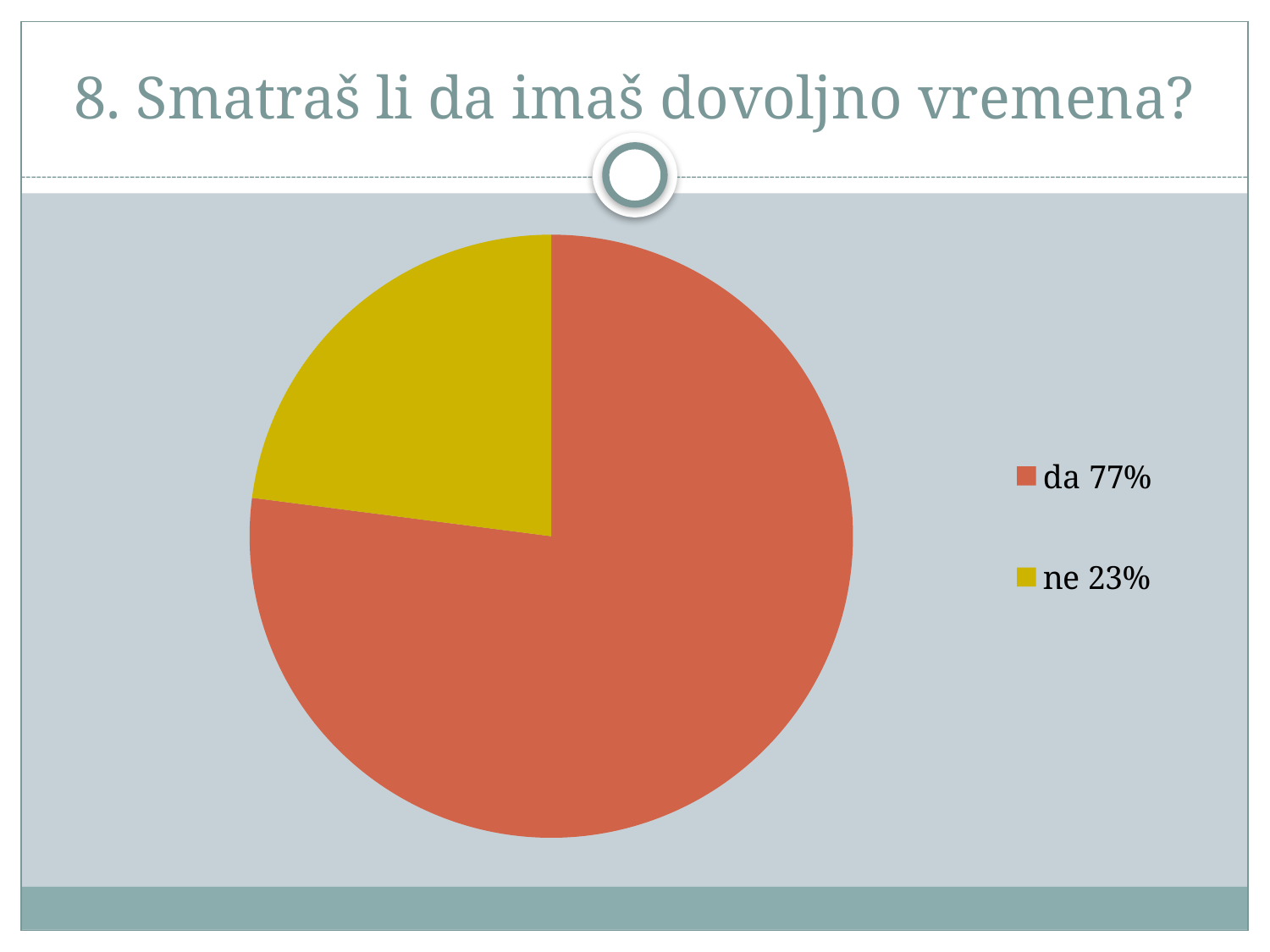
How many slices does the pie chart have? 2 What kind of chart is shown on the slide? pie chart Which category has the largest slice of the pie? da What is the difference in percentage points between the "da" and "ne" slices? 54 What colour is the "ne" slice of the pie? yellow Which is larger, the "da" slice or the "ne" slice? da What share of the pie does "da" represent? 77% How many entries does the legend list? 2 Which category has the smallest slice of the pie? ne What share of the pie does "ne" represent? 23% What is the title of the slide containing the chart? 8. Smatraš li da imaš dovoljno vremena?